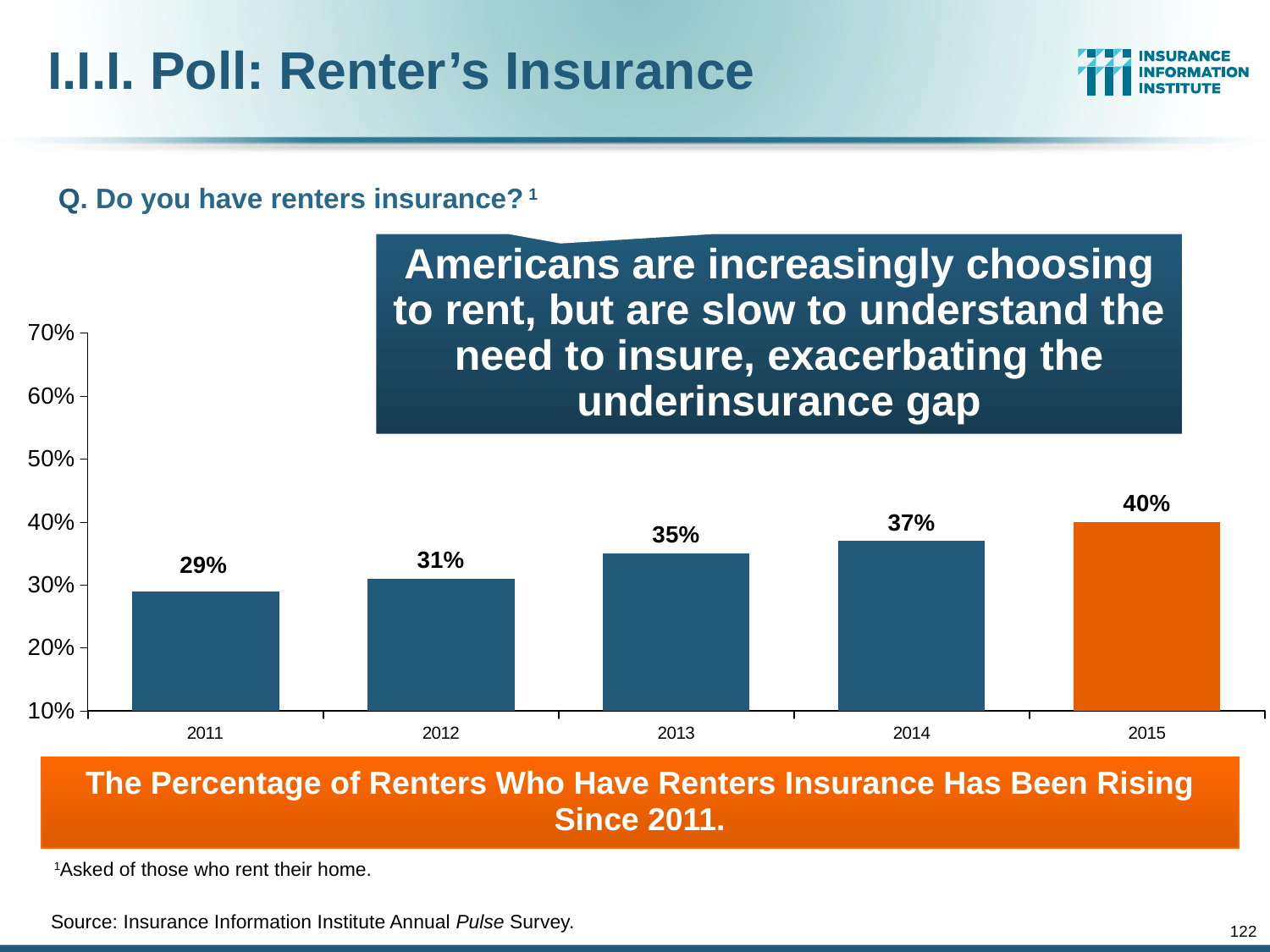
Which year has the highest percentage of renters with renters insurance? 2015 What is the difference between the 2015 value and the 2011 value? 11% Do the values rise or fall from 2011 to 2015? Rise What is the value shown for 2015? 40% What percentage of renters had renters insurance in 2011? 29% Is the value for 2013 greater or less than 30%? greater What is the value shown for 2013? 35% What is the difference between the 2014 value and the 2012 value? 6% Which year has a larger value, 2012 or 2014? 2014 What kind of chart is shown on the slide? Bar chart Which year has the lowest percentage of renters with renters insurance? 2011 How many years are shown on the x axis of the chart? 5